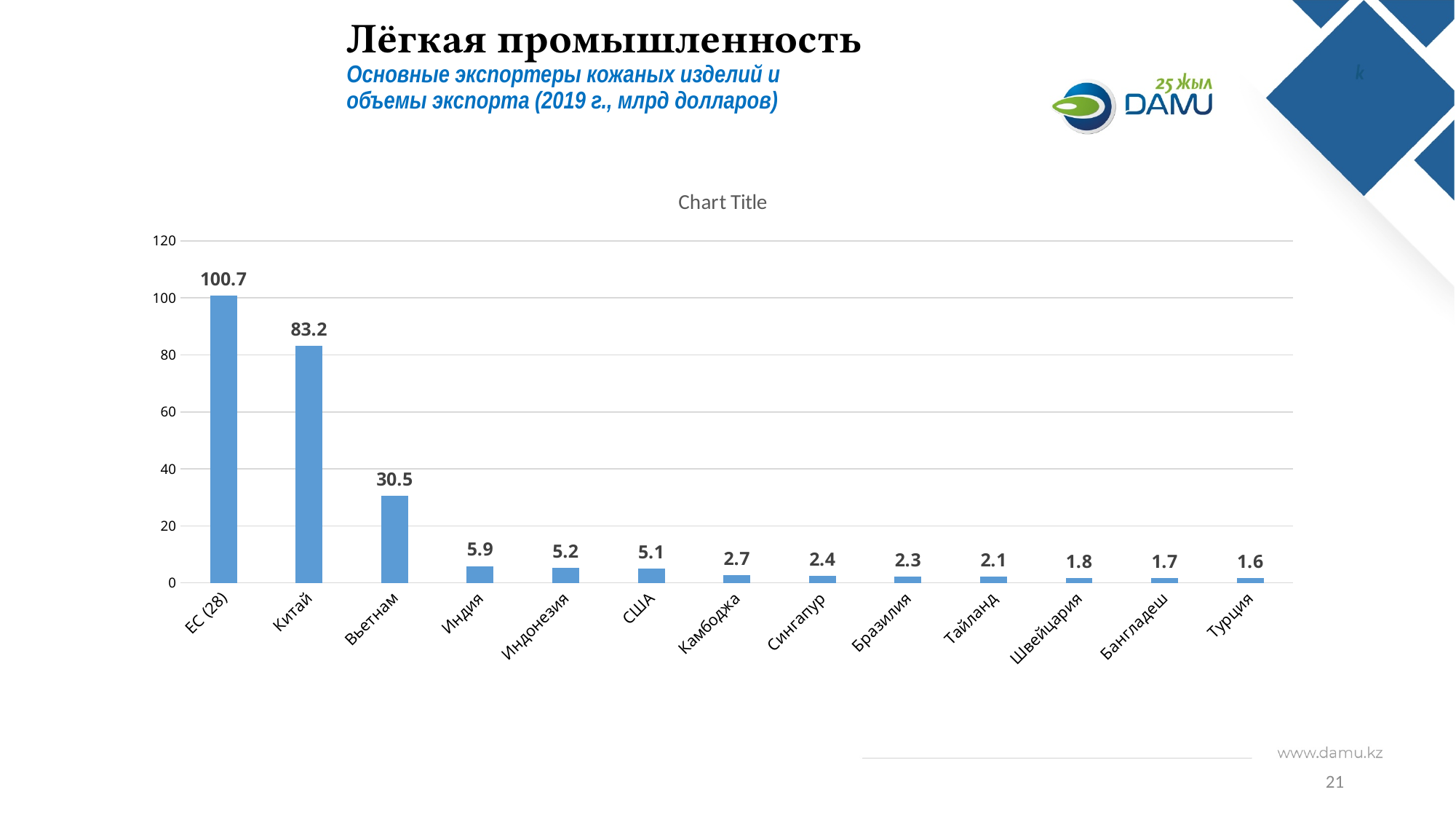
Which category has the highest value? ЕС (28) Which is larger, the value for Индия or the value for США? Индия What is the difference between the values for ЕС (28) and Китай? 17.5 What kind of chart is shown on the slide? bar chart Which category has the lowest value? Турция How many categories are shown on the x axis? 13 Is the value for Вьетнам greater or less than 40? less What is the value for Индонезия? 5.2 What is the value for Китай? 83.2 Do the values rise or fall from left to right along the x axis? fall What is the value for Вьетнам? 30.5 What is the title printed above the chart? Chart Title